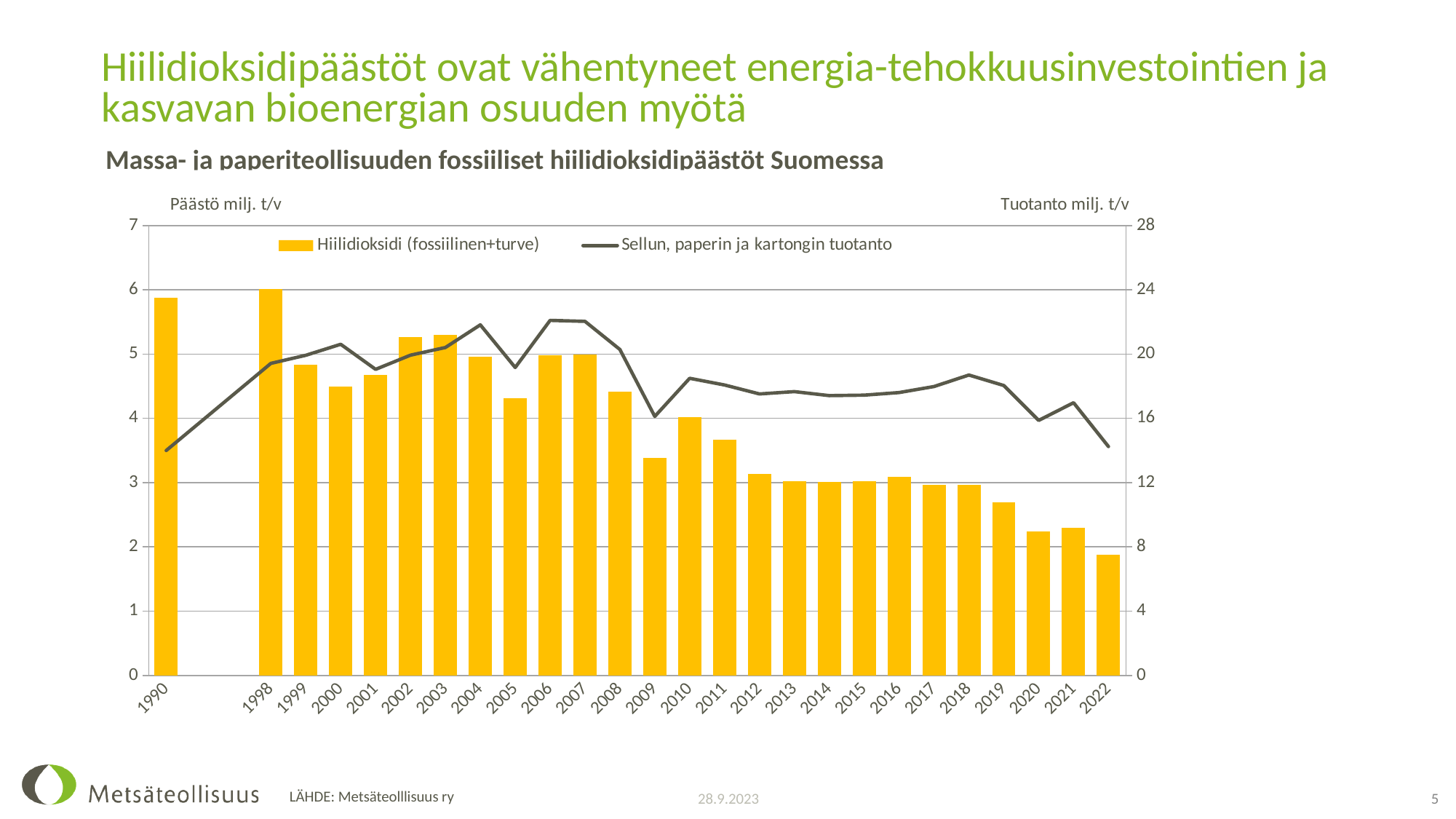
Is the Sellun, paperin ja kartongin tuotanto value for 2006 greater or less than 20 on the right axis? greater Is the Hiilidioksidi (fossiilinen+turve) value for 2022 greater or less than 2? less Which year has the larger Hiilidioksidi (fossiilinen+turve) bar, 2004 or 2005? 2004 Do the Hiilidioksidi (fossiilinen+turve) bars generally rise or fall from 1998 to 2022? Fall What is the label of the right-hand vertical axis? Tuotanto milj. t/v How many series does the legend list? 2 Which year has the lowest Hiilidioksidi (fossiilinen+turve) bar? 2022 Is the Hiilidioksidi (fossiilinen+turve) value for 2009 greater or less than 4? less What is the title of the chart? Massa- ja paperiteollisuuden fossiiliset hiilidioksidipäästöt Suomessa How many years are shown on the x axis? 26 What kind of chart is shown on the slide? A bar chart combined with a line